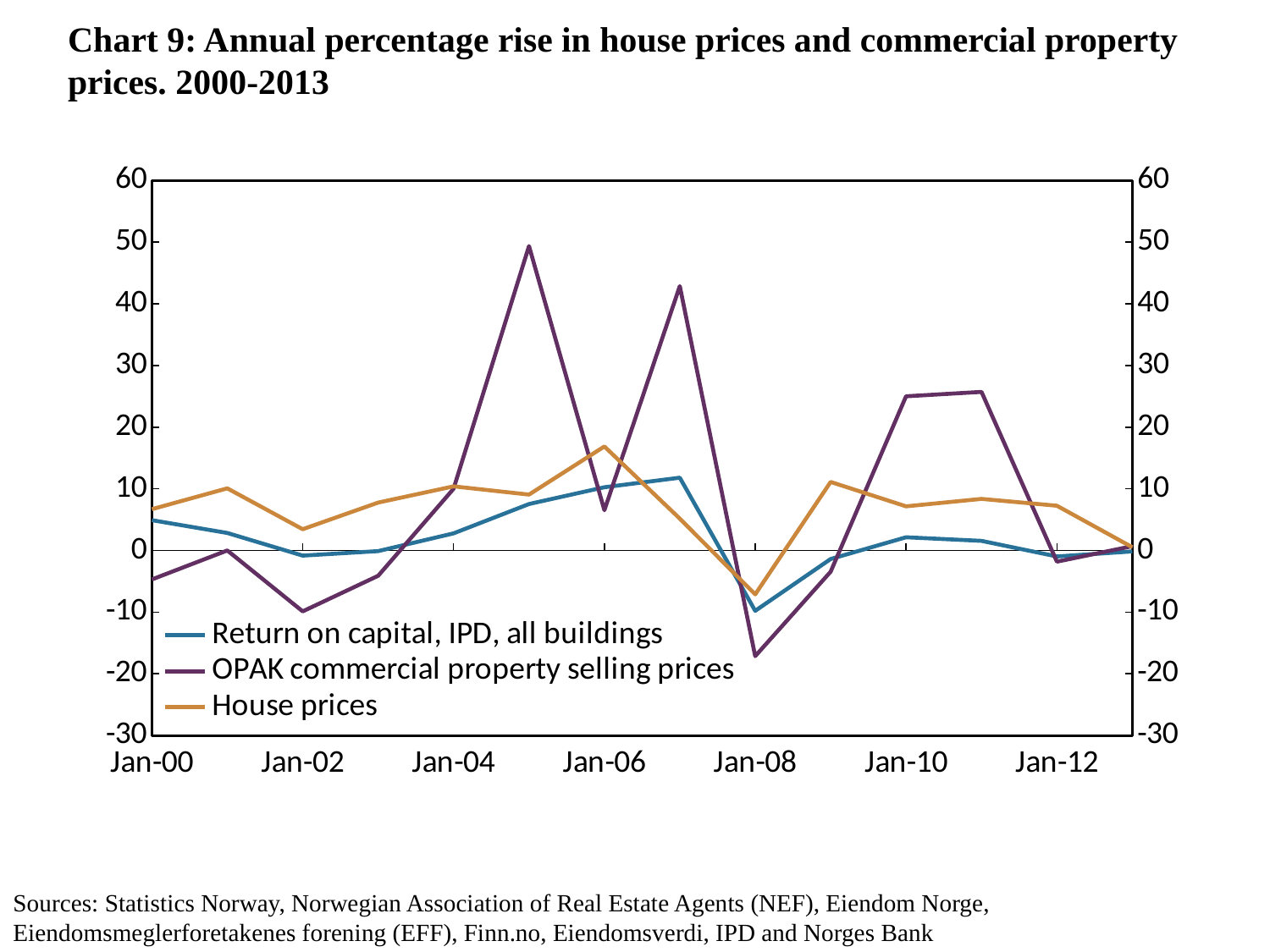
Is the value for OPAK commercial property selling prices at Jan-05 greater or less than 40? greater Which series reaches the highest value on the chart? OPAK commercial property selling prices What is the title of the chart? Chart 9: Annual percentage rise in house prices and commercial property prices. 2000-2013 What colour is the line for House prices? orange Does the House prices series rise or fall between Jan-06 and Jan-08? fall Is the value for OPAK commercial property selling prices at Jan-08 greater or less than -10? less Which series reaches the lowest value on the chart? OPAK commercial property selling prices Is the value for House prices at Jan-06 greater or less than 10? greater How many series does the legend list? 3 At Jan-05, which is larger: OPAK commercial property selling prices or House prices? OPAK commercial property selling prices What kind of chart is shown on the slide? line chart